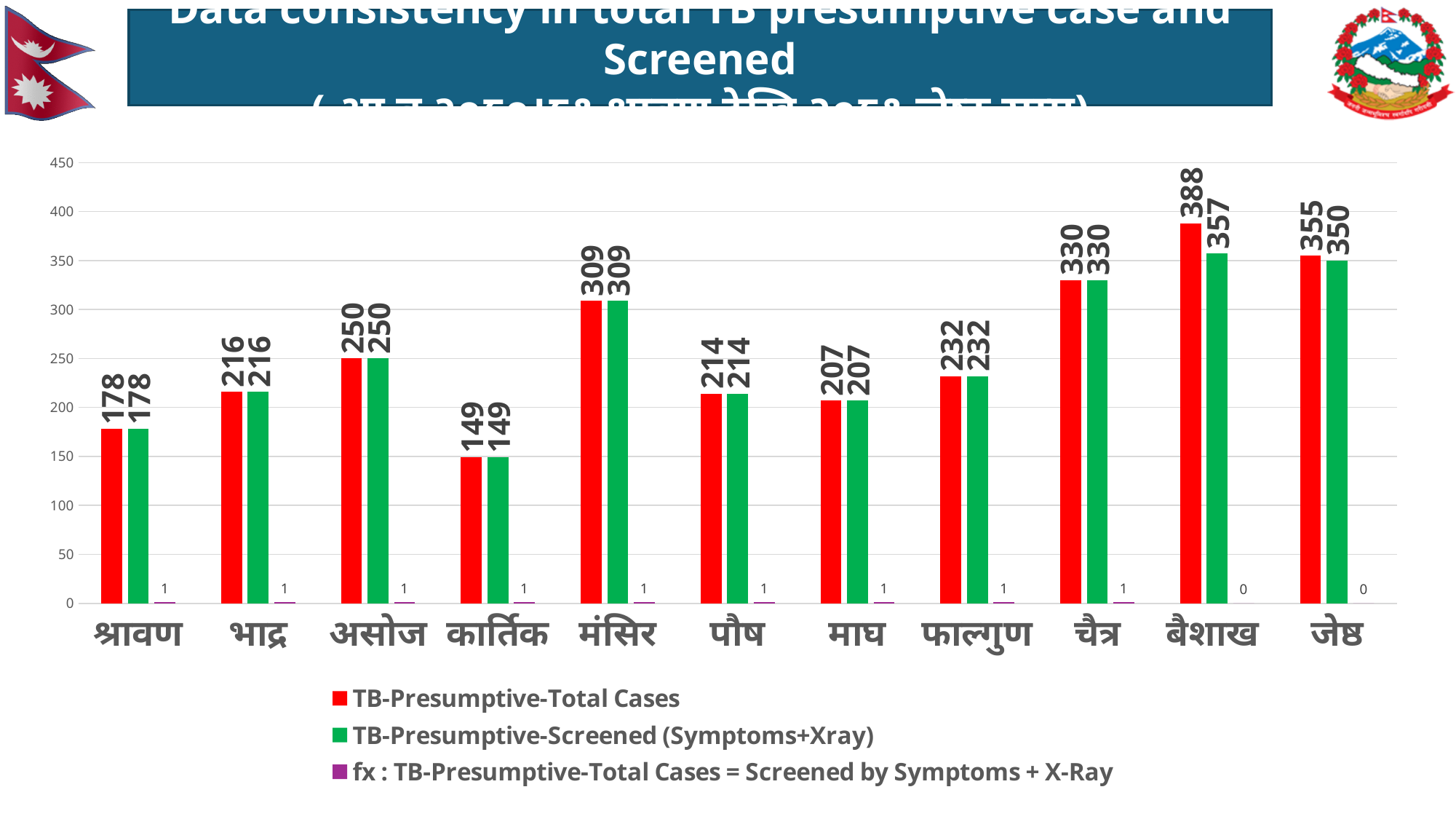
What is the difference between TB-Presumptive-Total Cases and TB-Presumptive-Screened (Symptoms+Xray) for बैशाख? 31 What is the value of TB-Presumptive-Screened (Symptoms+Xray) for जेष्ठ? 350 What colour are the bars for TB-Presumptive-Screened (Symptoms+Xray)? green What is the value of TB-Presumptive-Total Cases for कार्तिक? 149 What kind of chart is shown on the slide? bar chart What is the value of the fx series (TB-Presumptive-Total Cases = Screened by Symptoms + X-Ray) for बैशाख? 0 What is the value of TB-Presumptive-Total Cases for बैशाख? 388 Which is larger for जेष्ठ: TB-Presumptive-Total Cases or TB-Presumptive-Screened (Symptoms+Xray)? TB-Presumptive-Total Cases How many series does the legend list? 3 Which month has the highest TB-Presumptive-Total Cases? बैशाख Which month has the lowest TB-Presumptive-Screened (Symptoms+Xray) value? कार्तिक How many months (categories) are shown on the x axis? 11